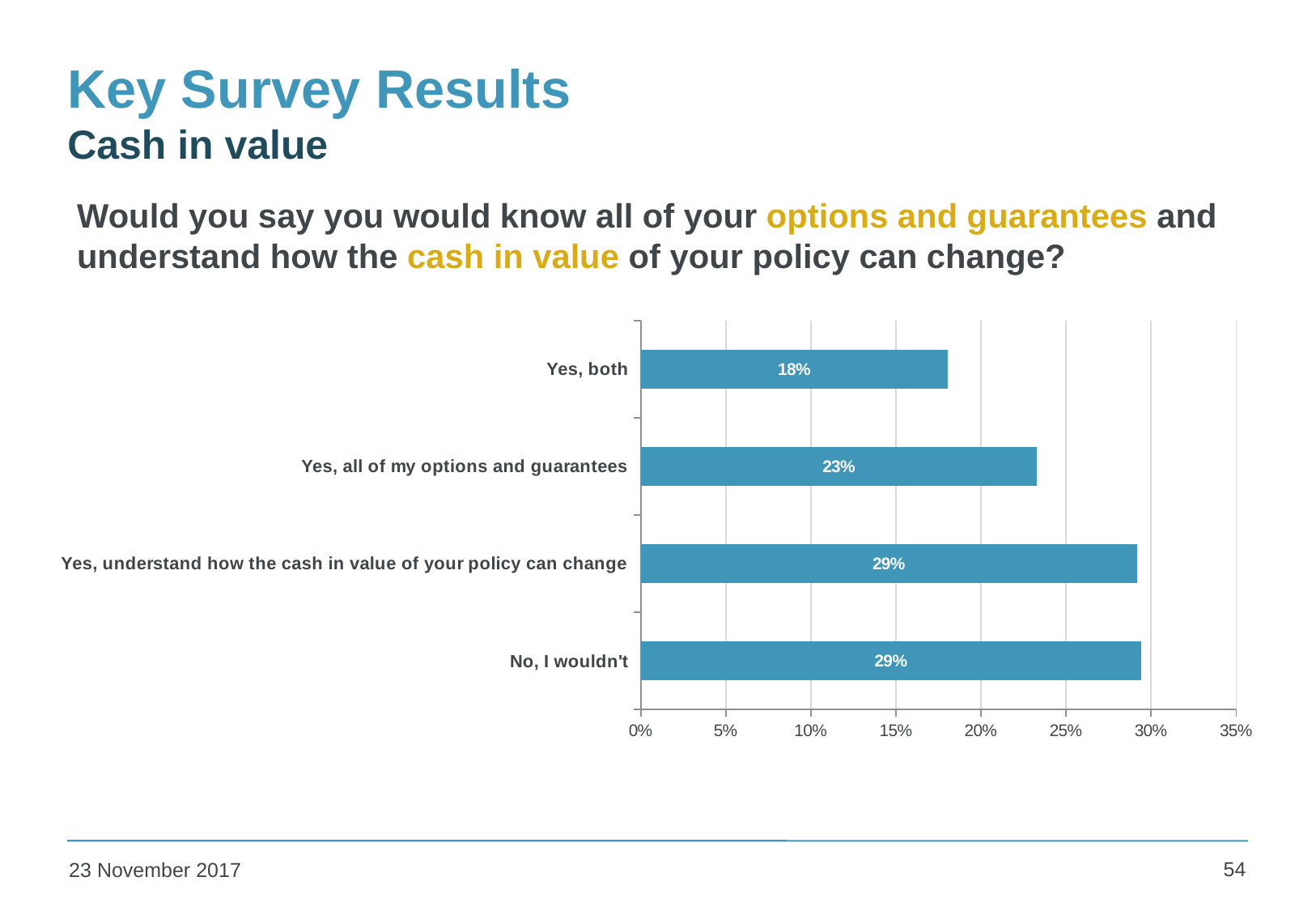
What percentage answered "No, I wouldn't"? 29% Which response category has the lowest value? Yes, both Is the value for "Yes, all of my options and guarantees" greater or less than 20%? greater What is the maximum value shown on the horizontal axis of the chart? 35% What percentage of respondents answered "Yes, both"? 18% What is the difference between the values for "Yes, all of my options and guarantees" and "Yes, both"? 5% Which is larger: the value for "Yes, all of my options and guarantees" or the value for "Yes, both"? Yes, all of my options and guarantees How many response categories are shown in the chart? 4 What is the difference between "No, I wouldn't" and "Yes, both"? 11% What is the value for "Yes, understand how the cash in value of your policy can change"? 29% What type of chart is shown on the slide? Bar chart What is the value for "Yes, all of my options and guarantees"? 23%